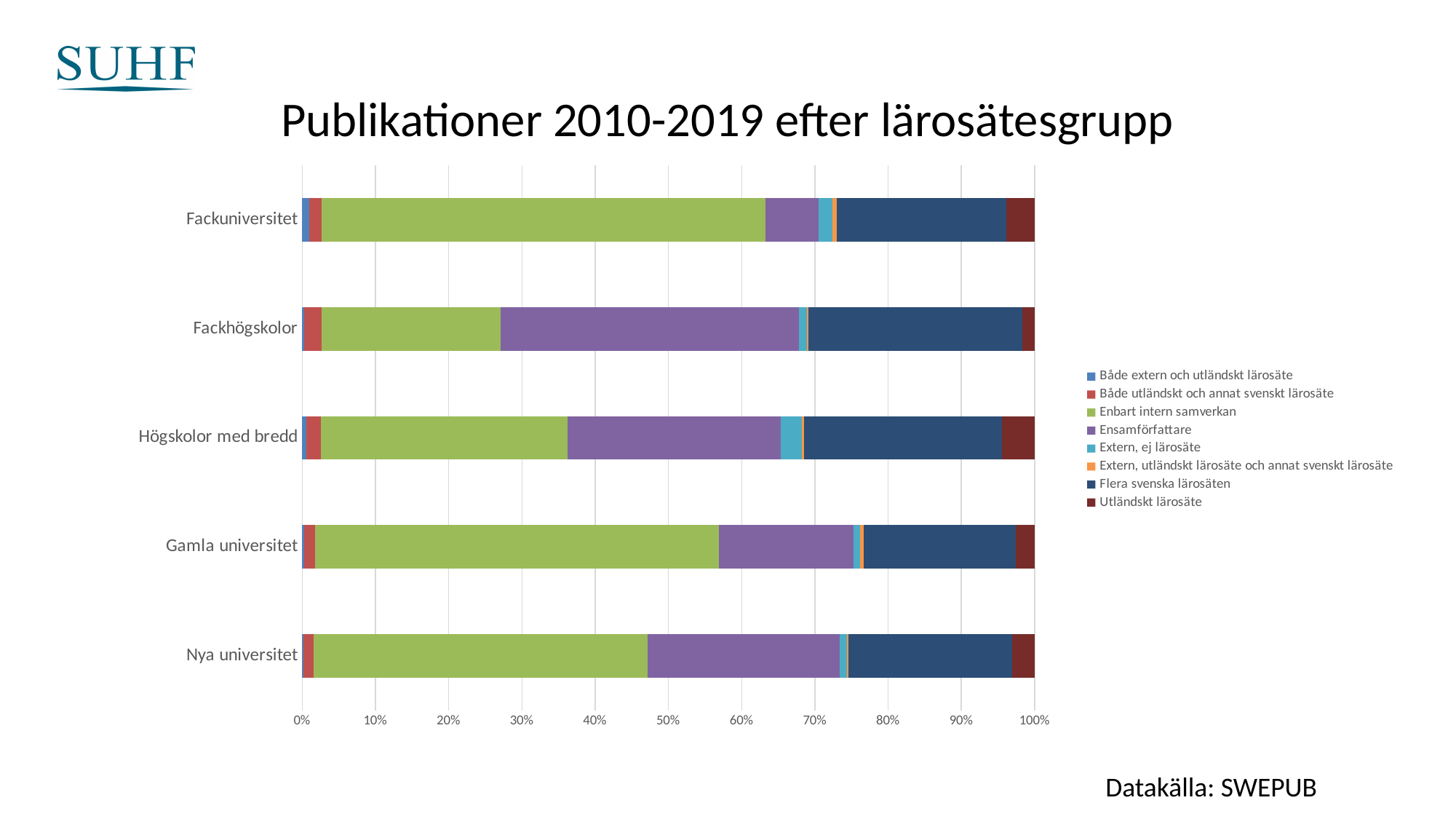
How many series does the legend list? 8 Which category has the largest share of 'Ensamförfattare'? Fackhögskolor Is the 'Enbart intern samverkan' share for Fackhögskolor greater or less than 30%? less How many institution groups (categories) are shown on the y axis? 5 What is the title of the chart? Publikationer 2010-2019 efter lärosätesgrupp What does each stacked bar total on the x axis? 100% Which category has the largest share of 'Enbart intern samverkan'? Fackuniversitet Which has a larger share of 'Utländskt lärosäte': Högskolor med bredd or Fackhögskolor? Högskolor med bredd Which category has the smallest share of 'Enbart intern samverkan'? Fackhögskolor Is the 'Enbart intern samverkan' share for Gamla universitet greater or less than 50%? greater Which has a larger share of 'Ensamförfattare': Fackhögskolor or Fackuniversitet? Fackhögskolor What kind of chart is shown on the slide? Stacked bar chart